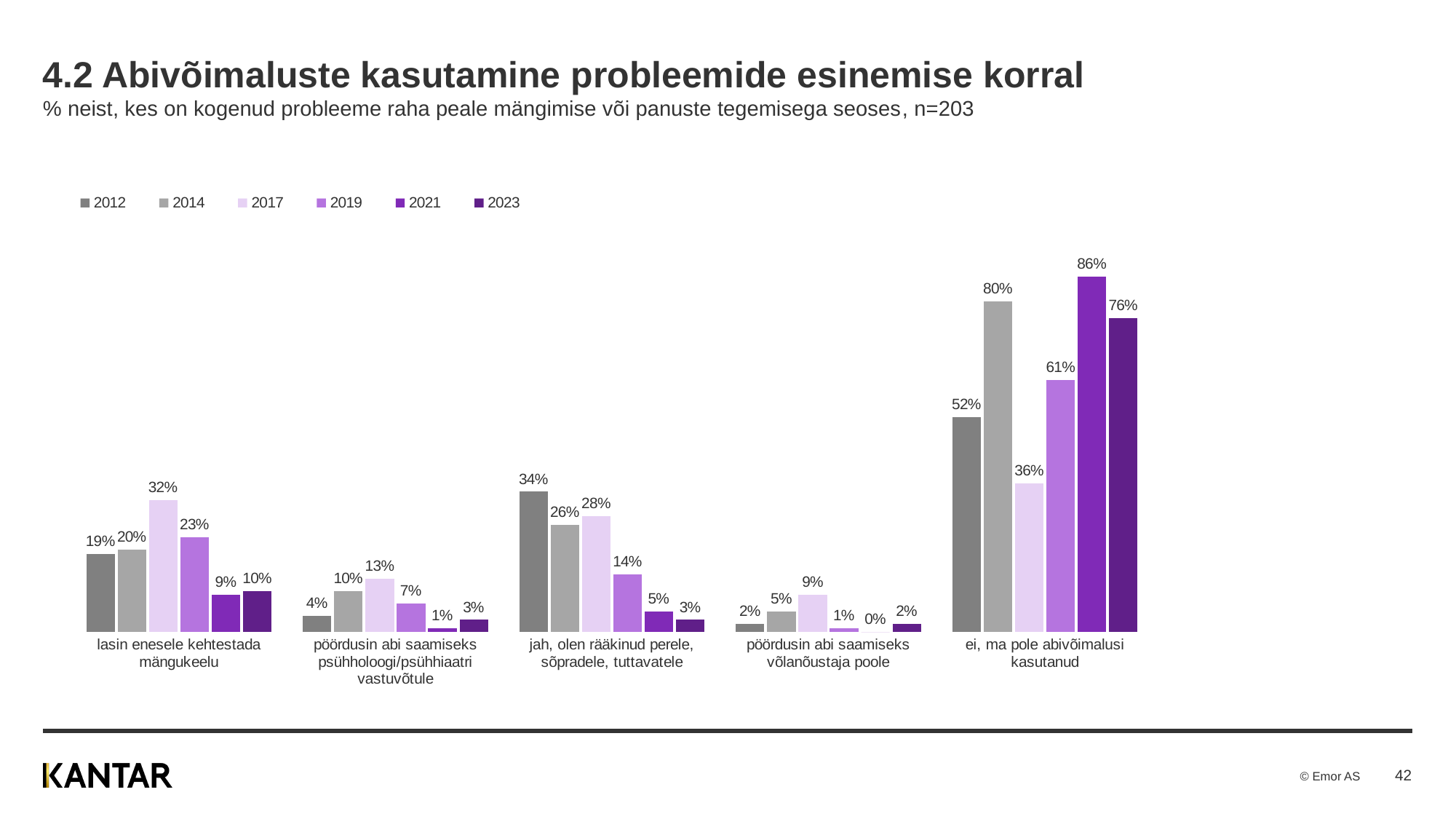
What is the value for 2023 in the category "ei, ma pole abivõimalusi kasutanud"? 76% What is the sample size (n) stated in the chart subtitle? n=203 What is the value for 2017 in the category "lasin enesele kehtestada mängukeelu"? 32% In the category "jah, olen rääkinud perele, sõpradele, tuttavatele", do the values rise or fall from 2017 to 2023? Fall Which year has the lowest value in the category "pöördusin abi saamiseks võlanõustaja poole"? 2021 Which year has the highest value in the category "ei, ma pole abivõimalusi kasutanud"? 2021 How many series does the legend list? 6 Which is larger in the category "pöördusin abi saamiseks psühholoogi/psühhiaatri vastuvõtule": the 2017 value or the 2019 value? 2017 What kind of chart is shown on the slide? Bar chart How many categories are shown on the x axis? 5 What is the value for 2012 in the category "jah, olen rääkinud perele, sõpradele, tuttavatele"? 34% What is the difference between the 2021 and 2023 values in the category "ei, ma pole abivõimalusi kasutanud"? 10%